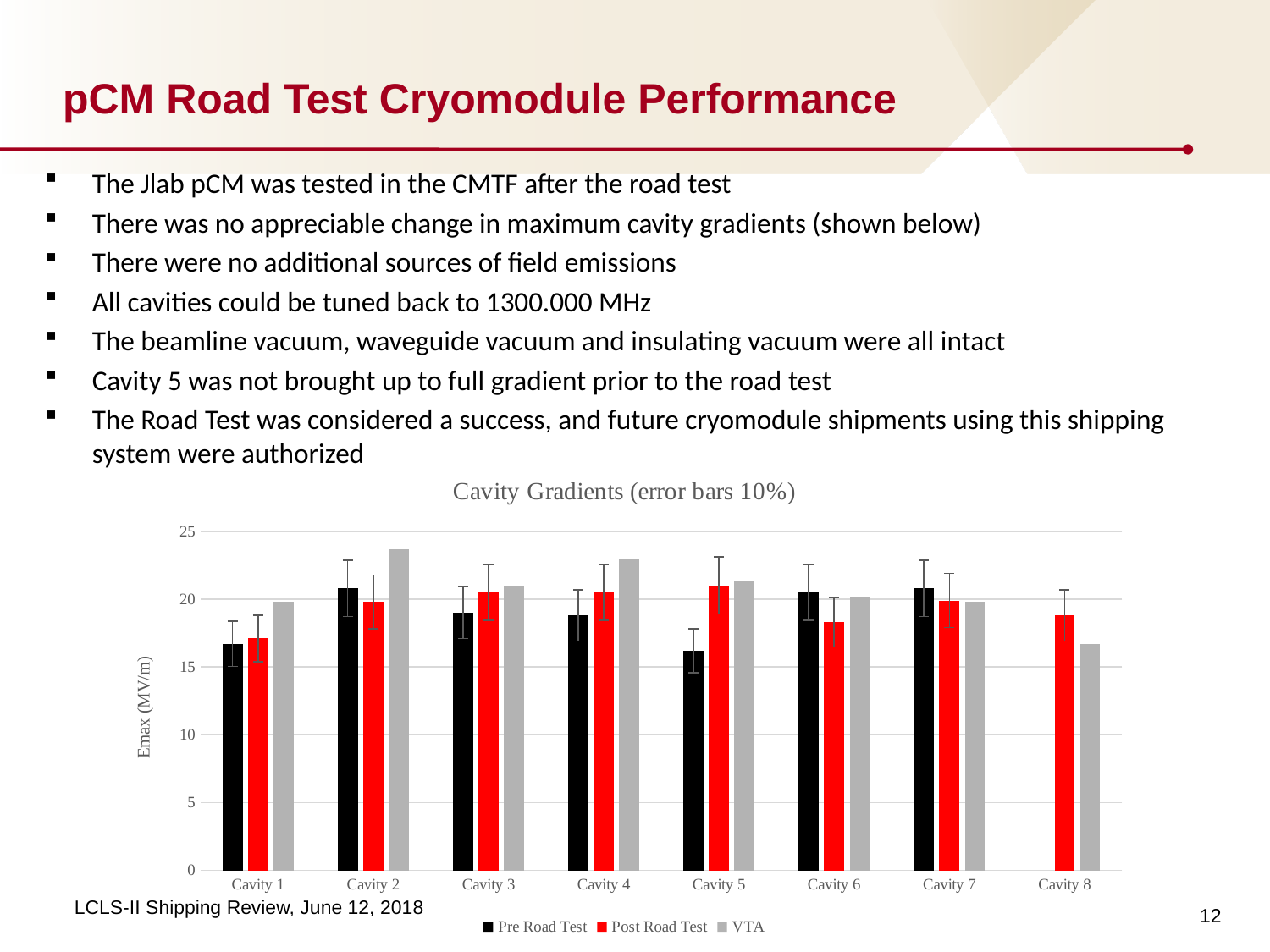
Is the VTA value for Cavity 8 greater or less than 20? less Is the VTA value for Cavity 2 greater or less than 20? greater For Cavity 5, which is larger: the Pre Road Test value or the Post Road Test value? Post Road Test What is the label of the y axis? Emax (MV/m) Which is larger: the VTA value for Cavity 2 or the VTA value for Cavity 8? Cavity 2 Is the Pre Road Test value for Cavity 5 greater or less than 20? less How many series does the chart legend list? 3 What is the title of the chart? Cavity Gradients (error bars 10%) Which cavity has the lowest VTA value? Cavity 8 How many cavities are shown on the x axis of the chart? 8 What type of chart is shown on the slide? bar chart